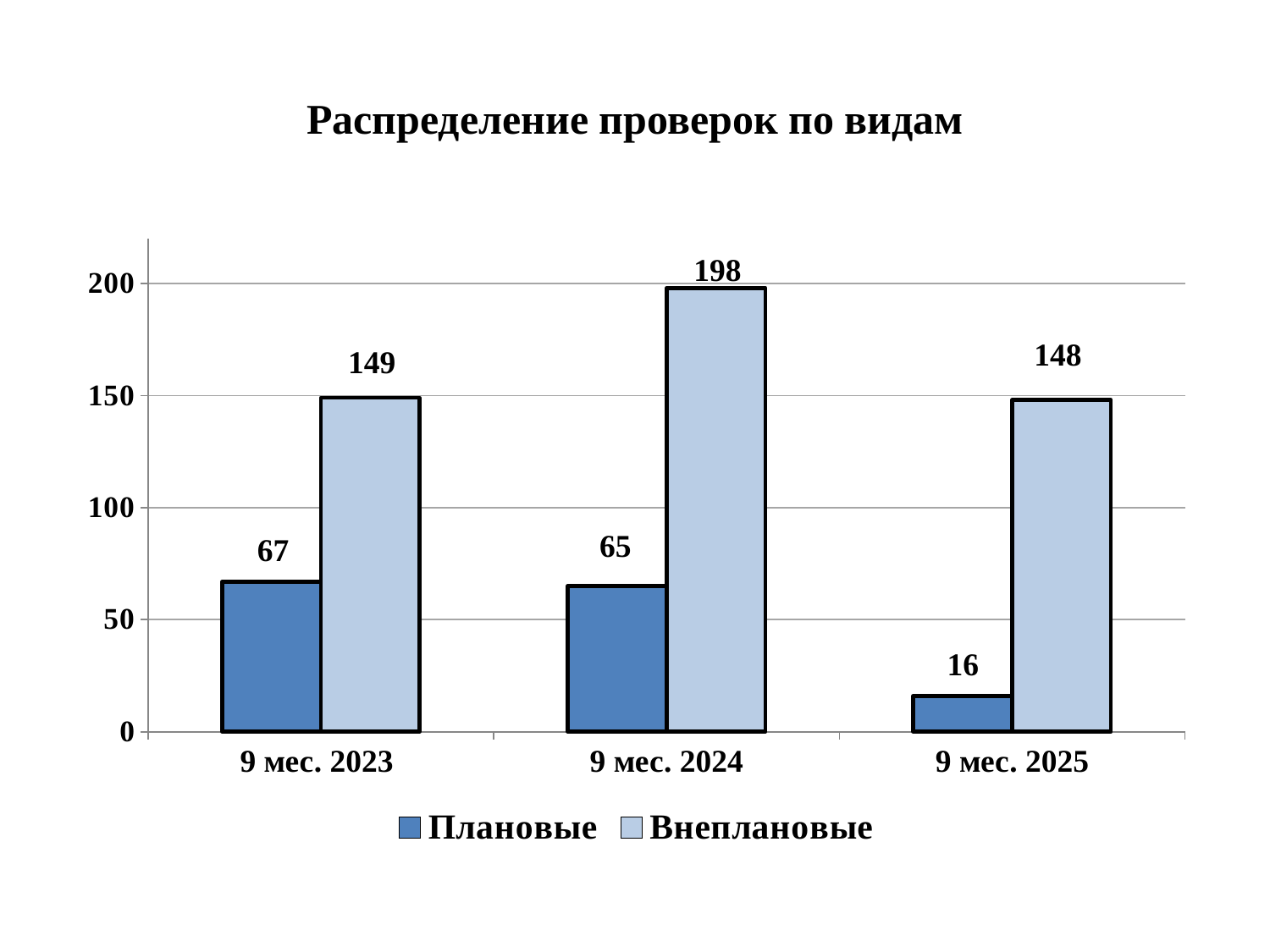
What is the difference between Внеплановые in 9 мес. 2023 and 9 мес. 2025? 1 Which is larger: Плановые in 9 мес. 2023 or Плановые in 9 мес. 2024? Плановые in 9 мес. 2023 What kind of chart is shown on the slide? bar chart What is the difference between Внеплановые and Плановые in 9 мес. 2024? 133 What is the title of the chart? Распределение проверок по видам Which period has the highest value for Внеплановые? 9 мес. 2024 What is the value for Плановые in 9 мес. 2023? 67 What is the value for Внеплановые in 9 мес. 2024? 198 How many series does the legend list? 2 How many periods are shown on the x axis? 3 What is the value for Плановые in 9 мес. 2025? 16 Which period has the lowest value for Плановые? 9 мес. 2025